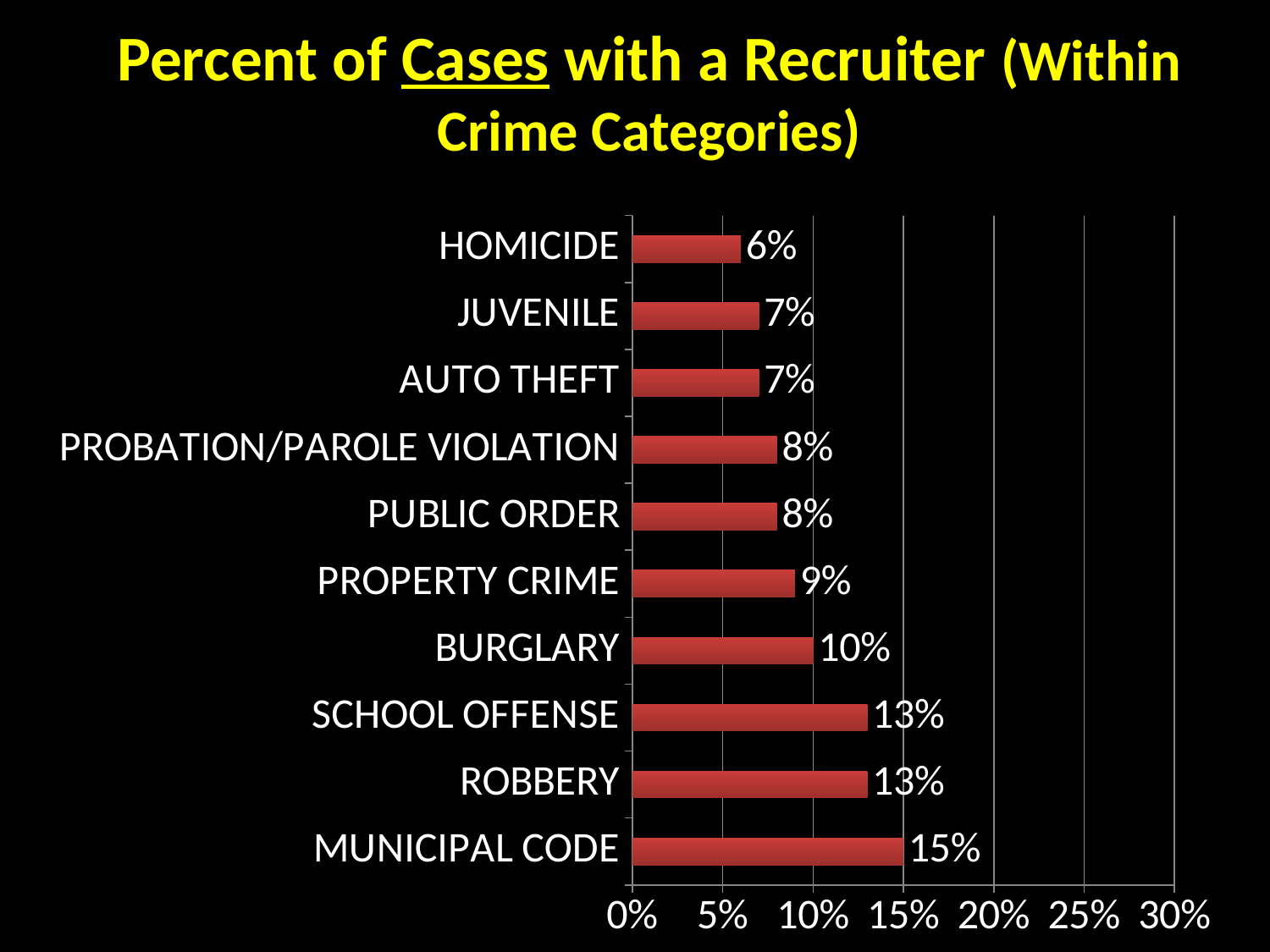
What percent of Municipal Code cases have a recruiter? 15% What percent of Burglary cases have a recruiter? 10% What kind of chart is shown on the slide? Bar chart What is the difference between the values for Municipal Code and Homicide? 9% What is the difference between the values for School Offense and Burglary? 3% Which has a higher value, Property Crime or Robbery? Robbery Which crime category has the highest percent of cases with a recruiter? Municipal Code Is the value for Municipal Code greater or less than 20%? less What is the value shown for Homicide? 6% What is the maximum value shown on the horizontal axis? 30% Which crime category has the lowest percent of cases with a recruiter? Homicide How many crime categories are shown in the chart? 10